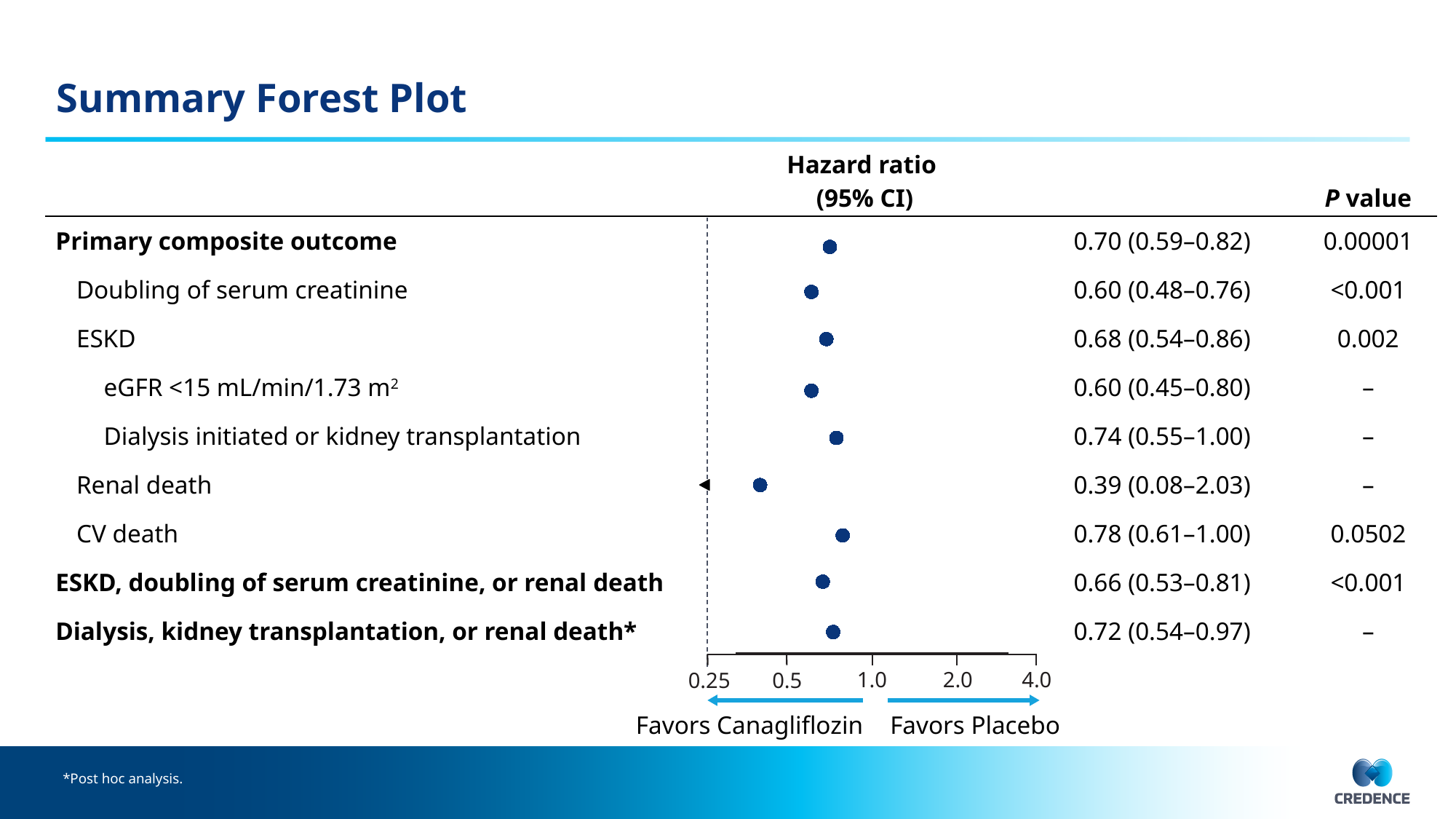
How many outcomes are plotted in the forest plot? 9 Which outcome has the lowest hazard ratio? Renal death What is the P value for CV death? 0.0502 What is the 95% CI for Renal death? 0.08–2.03 Which side of the axis is labelled 'Favors Placebo'? Right Which has the larger hazard ratio, Doubling of serum creatinine or Dialysis initiated or kidney transplantation? Dialysis initiated or kidney transplantation Is the hazard ratio for ESKD, doubling of serum creatinine, or renal death greater or less than 1.0? less What is the hazard ratio for the Primary composite outcome? 0.70 What is the difference between the hazard ratios for CV death and Renal death? 0.39 What is the hazard ratio (95% CI) for ESKD? 0.68 (0.54–0.86) What kind of chart is shown on the slide? Forest plot Which outcome has the highest hazard ratio? CV death